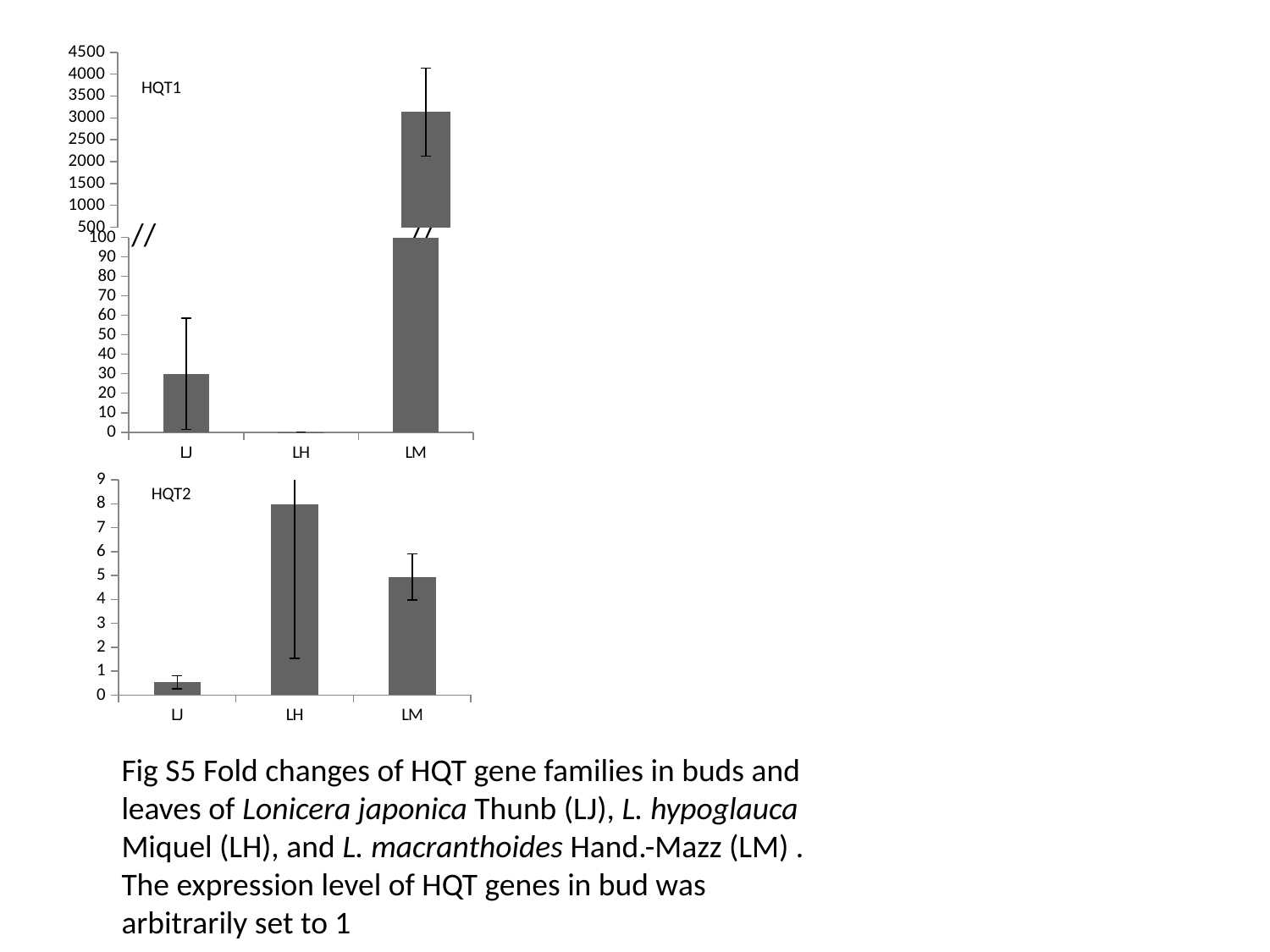
What kind of chart is the HQT1 chart? bar chart In the HQT2 chart, is the value for LJ greater or less than 1? less In the HQT2 chart, which category has the lowest value? LJ In the HQT1 chart, which category has the lowest value? LH What is the label shown inside the top chart? HQT1 In the HQT2 chart, which is larger, the value for LH or the value for LM? LH How many categories are shown on the x axis of the HQT2 chart? 3 In the HQT2 chart, which category has the highest value? LH In the HQT1 chart, is the value for LM greater or less than 2500? greater In the HQT1 chart, is the value for LJ greater or less than 50? less In the HQT1 chart, which category has the highest value? LM